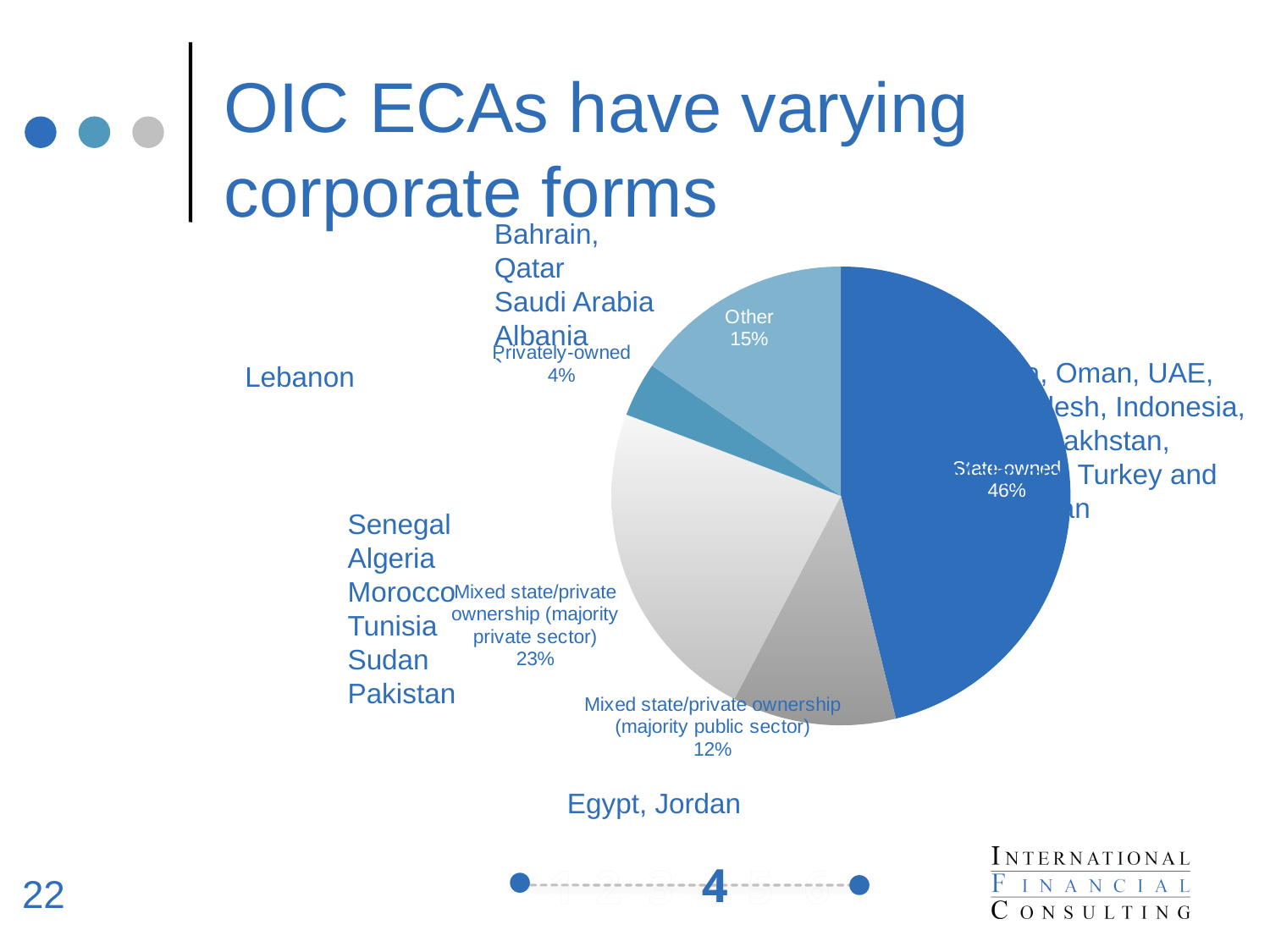
What is the title of the slide containing the pie chart? OIC ECAs have varying corporate forms What share of the pie is labelled Other? 15% What share of the pie is Mixed state/private ownership (majority public sector)? 12% How many slices does the pie chart have? 5 What share of the pie is Privately-owned? 4% What share of the pie is State-owned? 46% Which is larger: the Other slice or the Mixed state/private ownership (majority public sector) slice? Other What share of the pie is Mixed state/private ownership (majority private sector)? 23% Which slice of the pie is the largest? State-owned What kind of chart is shown on the slide? pie chart What is the difference in percentage points between the State-owned slice and the Mixed state/private ownership (majority private sector) slice? 23 Which slice of the pie is the smallest? Privately-owned